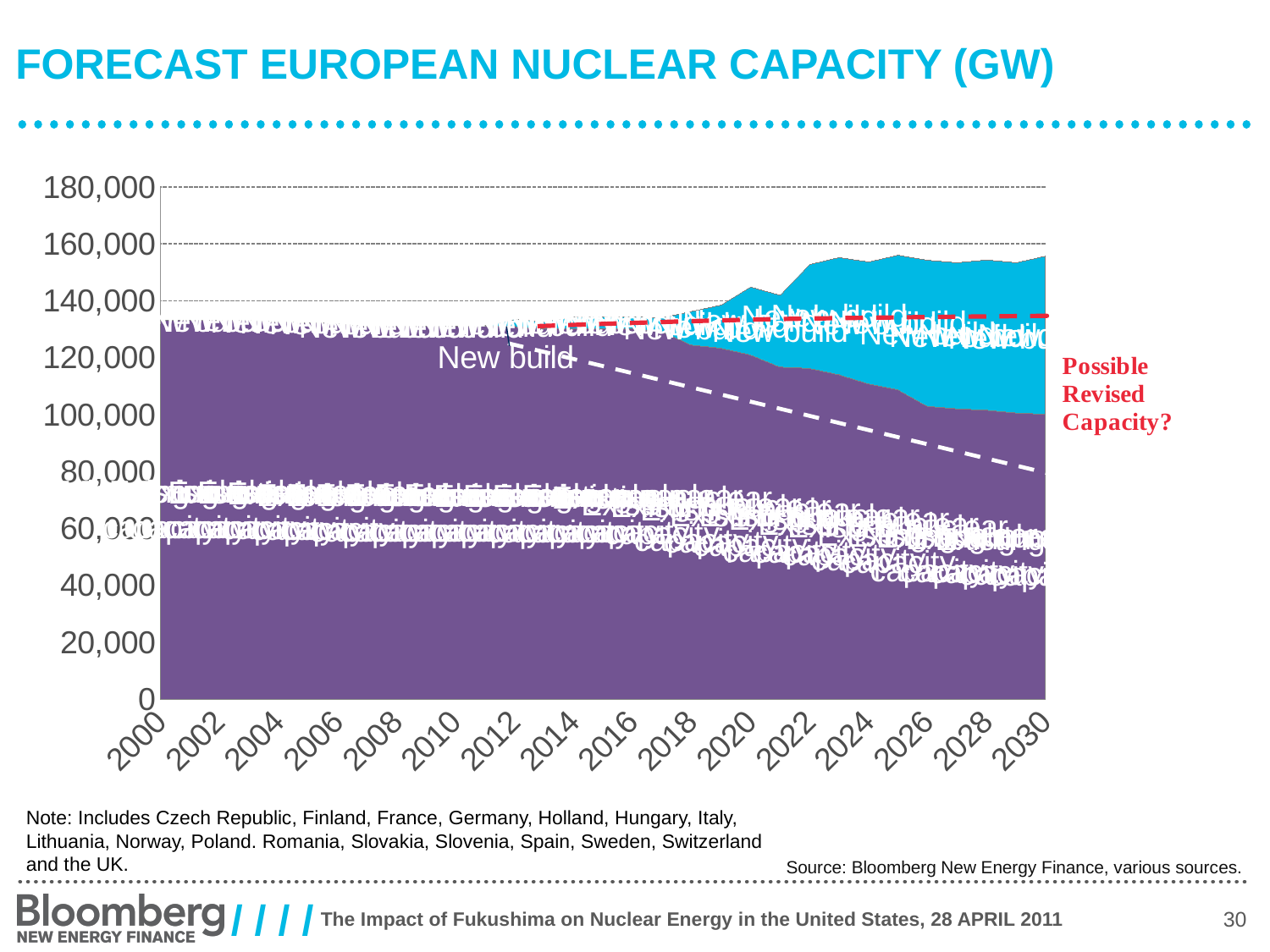
Does the blue (new build) area rise or fall between 2016 and 2024? rise Is the existing capacity (purple area) in 2030 greater or less than 120,000? less What kind of chart is shown on the slide? Area chart Is the total capacity in 2000 greater or less than 140,000? less Is the total capacity in 2000 greater or less than 120,000? greater Which is larger: the total forecast capacity in 2030 or the total capacity in 2000? 2030 What label is attached to the red dashed line on the chart? Possible Revised Capacity? How many year labels are shown on the x axis? 16 What is the title of the chart? FORECAST EUROPEAN NUCLEAR CAPACITY (GW) Does the purple (existing capacity) area rise or fall between 2012 and 2030? fall